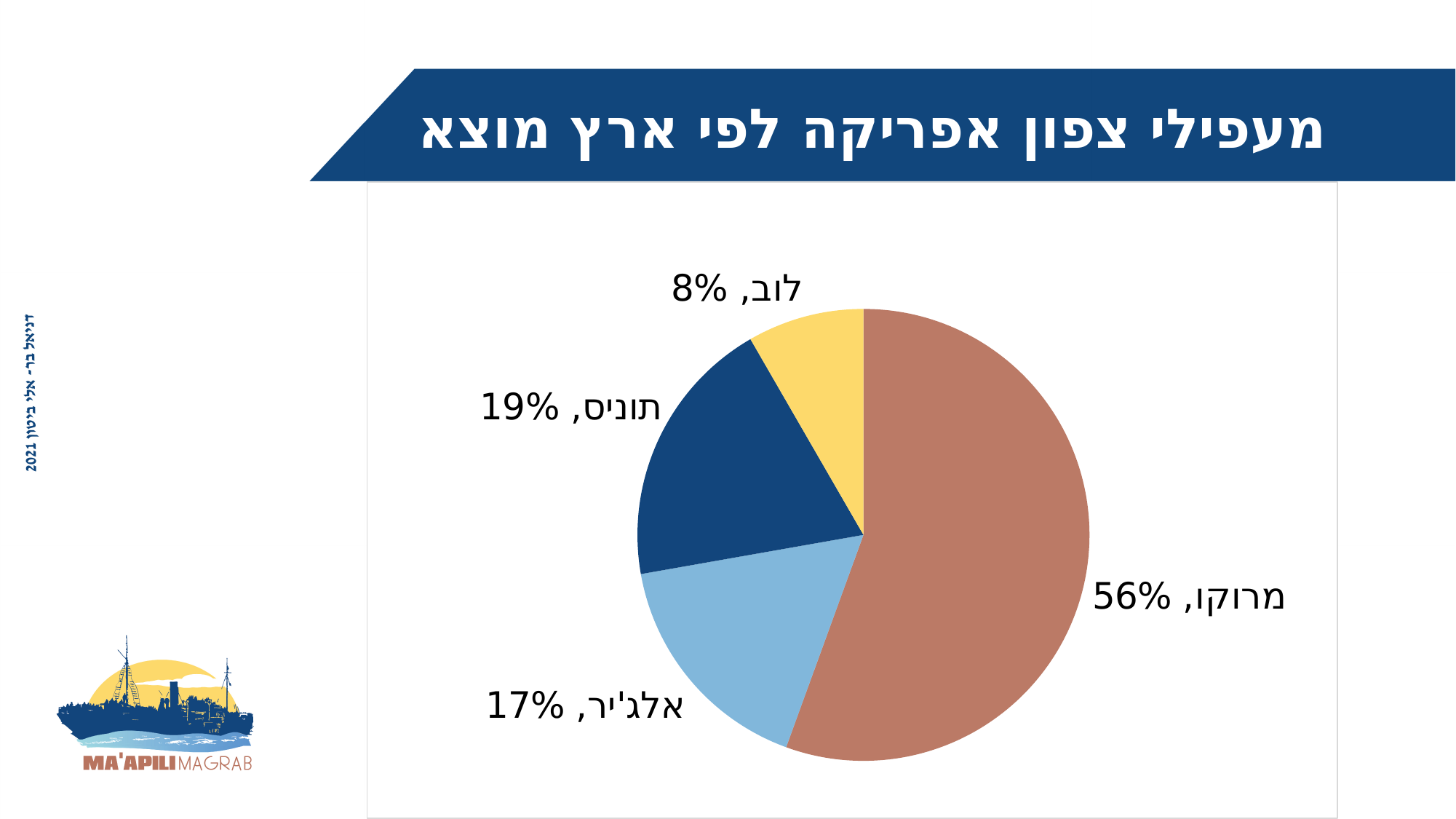
Which country has the largest slice of the pie chart? מרוקו What is the difference in percentage points between תוניס and אלג'יר? 2 Which is larger, the share for תוניס or the share for לוב? תוניס Which country has the smallest slice of the pie chart? לוב What is the share for תוניס in the pie chart? 19% What is the title of the chart on the slide? מעפילי צפון אפריקה לפי ארץ מוצא What is the difference in percentage points between מרוקו and תוניס? 37 What kind of chart is shown on the slide? pie chart What is the share for מרוקו in the pie chart? 56% What is the share for אלג'יר in the pie chart? 17% What is the share for לוב in the pie chart? 8% How many slices does the pie chart have? 4